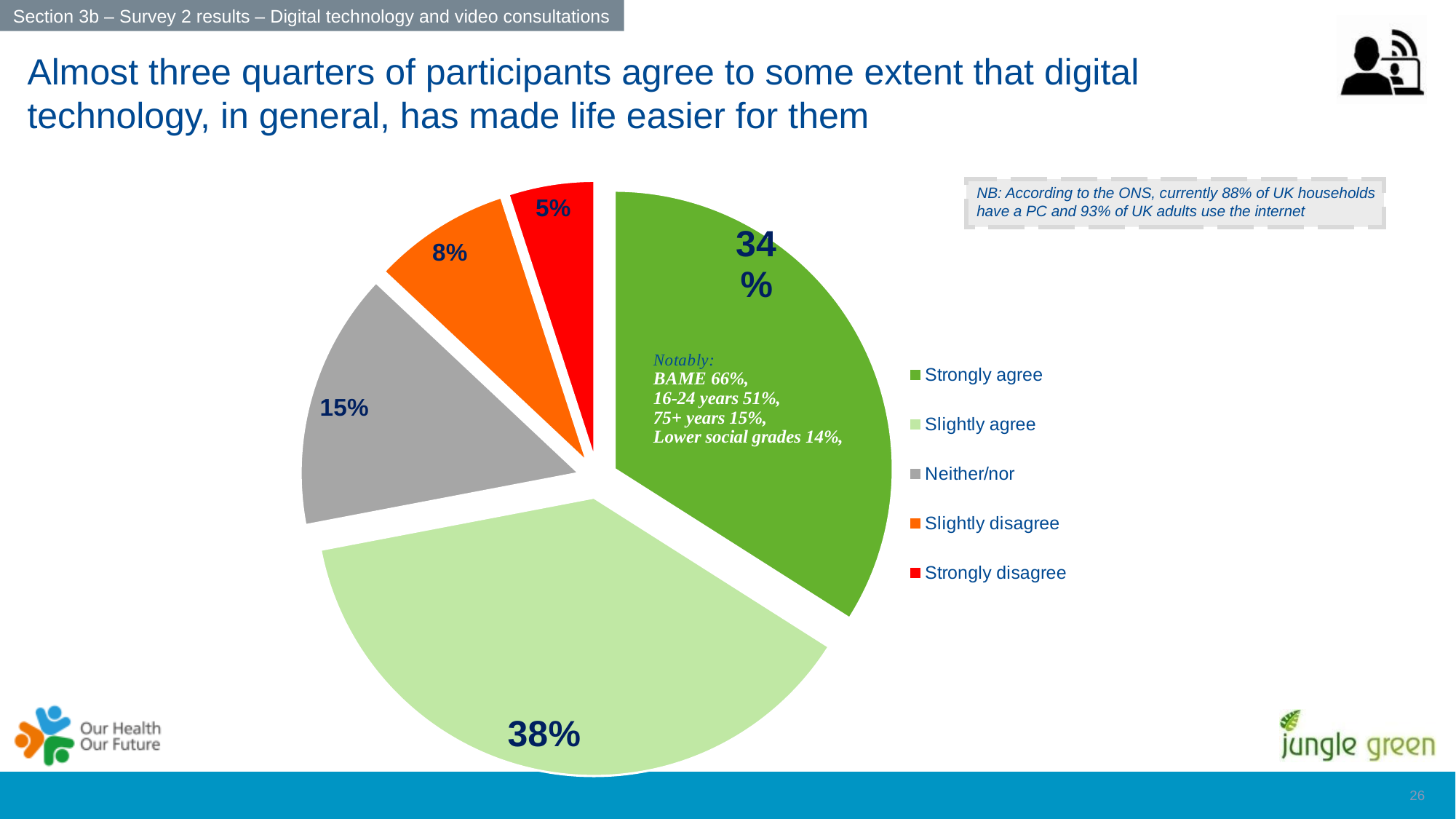
What percentage of participants slightly disagree? 8% Which response category has the largest share of the pie? Slightly agree What is the difference in percentage points between Slightly agree and Strongly agree? 4 What percentage of participants slightly agree? 38% What percentage of participants answered Neither/nor? 15% Which is larger, the share for Neither/nor or the share for Slightly disagree? Neither/nor What percentage of participants strongly agree that digital technology has made life easier for them? 34% What percentage of participants strongly disagree? 5% What kind of chart is shown on the slide? Pie chart Which response category has the smallest share of the pie? Strongly disagree What colour is the Strongly disagree slice? Red How many categories does the pie chart show? 5